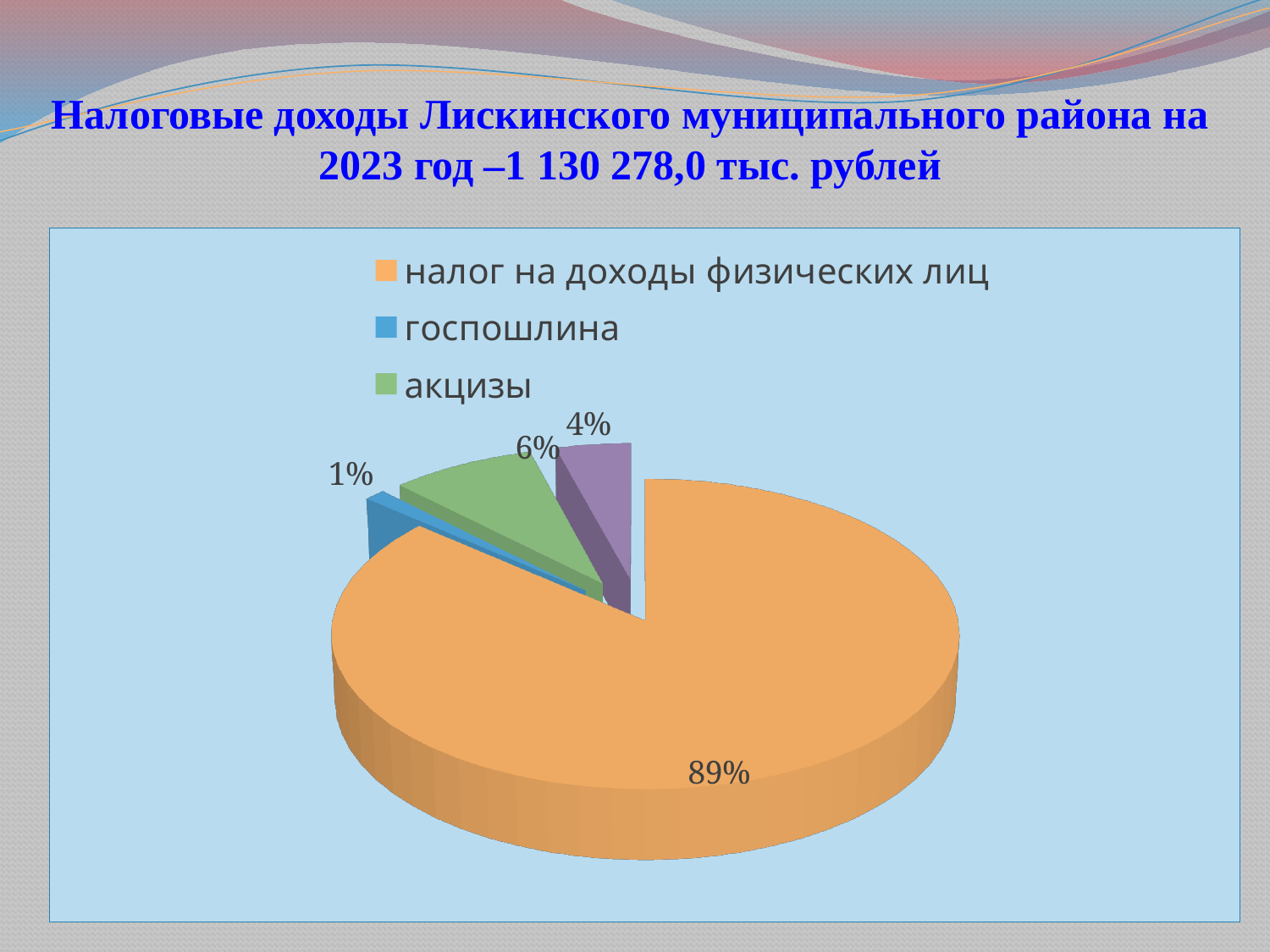
What share of the pie does "госпошлина" have? 1% What share of the pie does "акцизы" have? 6% What total amount of tax revenue is stated in the slide title? 1 130 278,0 тыс. рублей What colour is the slice for "налог на доходы физических лиц"? orange Which is larger, the share of "акцизы" or the share of "госпошлина"? акцизы Which category has the largest slice of the pie? налог на доходы физических лиц How many entries does the legend list? 3 How many slices does the pie chart have? 4 Which category has the smallest slice of the pie? госпошлина What kind of chart is shown on the slide? pie chart What share of the pie does "налог на доходы физических лиц" have? 89% What is the difference in percentage points between the shares of "акцизы" and "госпошлина"? 5